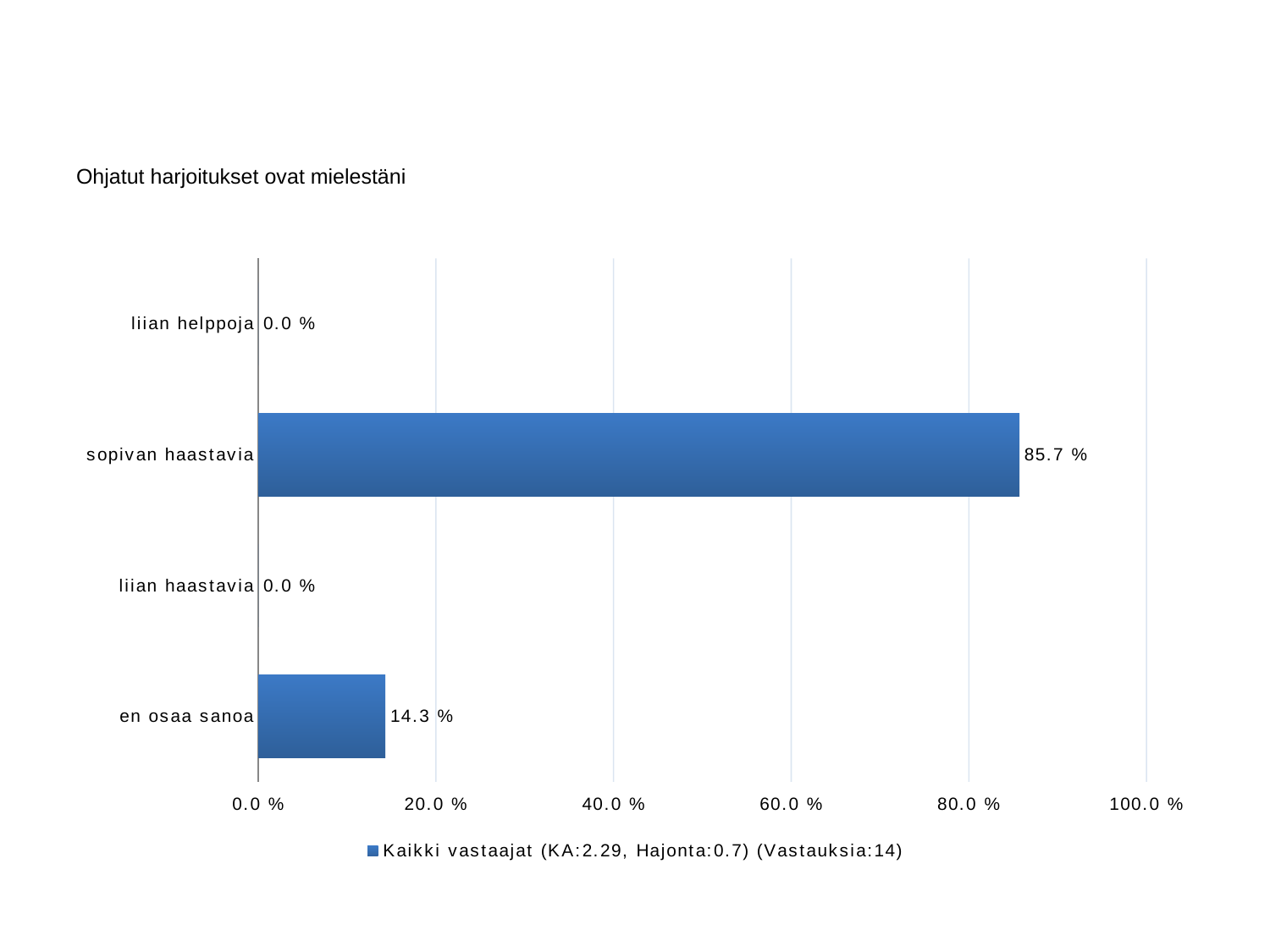
Is the value for "sopivan haastavia" greater or less than 80.0 %? greater Which is larger, the value for "sopivan haastavia" or the value for "en osaa sanoa"? sopivan haastavia What is the value for "liian helppoja"? 0.0 % What is the value for "liian haastavia"? 0.0 % What is the value for "en osaa sanoa"? 14.3 % What is the title of the chart? Ohjatut harjoitukset ovat mielestäni Is the value for "en osaa sanoa" greater or less than 20.0 %? less Which category has the highest value? sopivan haastavia What is the value for "sopivan haastavia"? 85.7 % How many categories are shown on the chart? 4 What is the difference between the values for "sopivan haastavia" and "en osaa sanoa"? 71.4 % What kind of chart is shown on the slide? bar chart